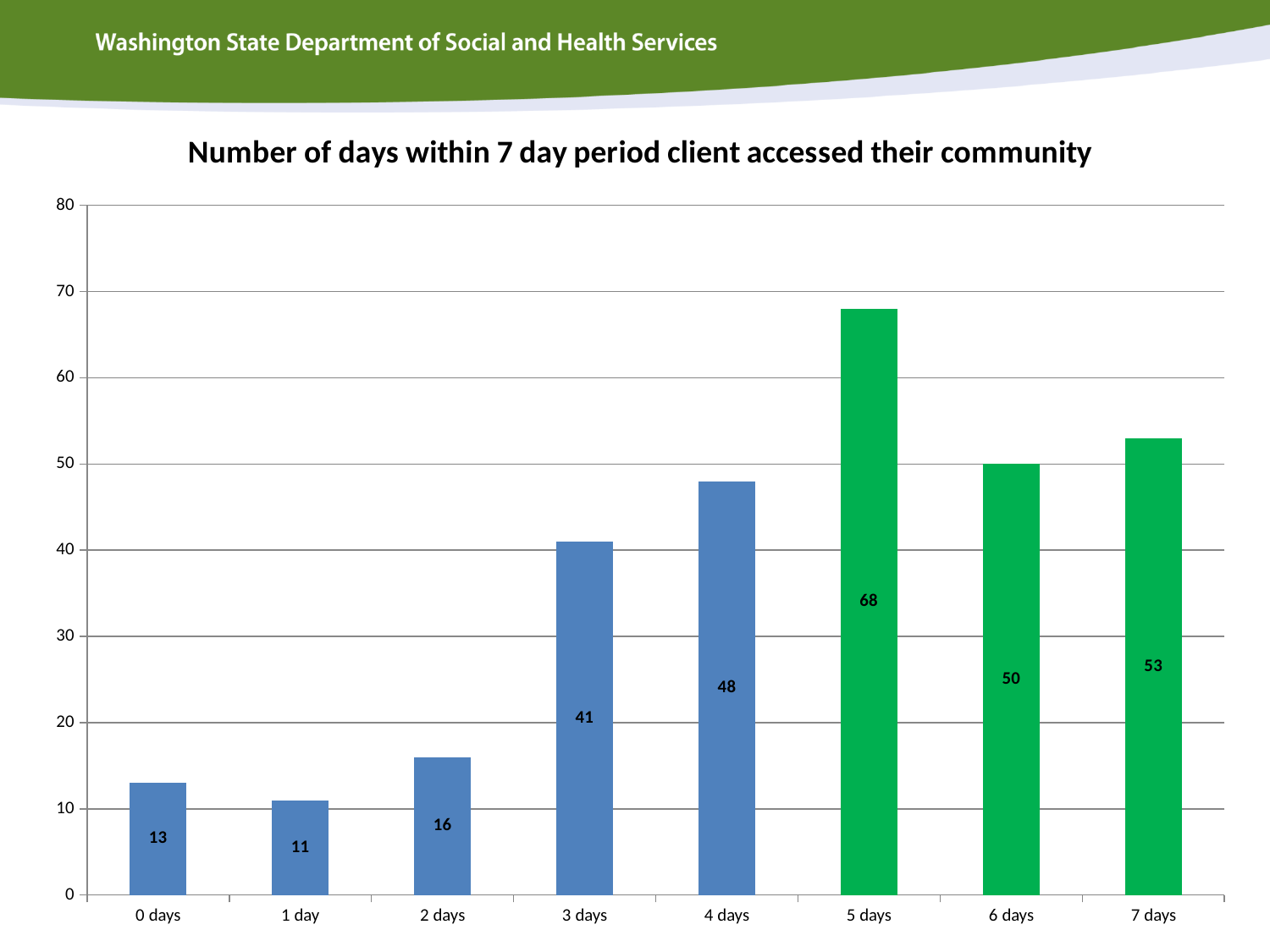
Which is larger, the value for 7 days or the value for 6 days? 7 days How many categories are shown on the x axis? 8 What is the title of the chart? Number of days within 7 day period client accessed their community What colour are the bars for 5 days, 6 days and 7 days? green What kind of chart is shown on the slide? bar chart Which category has the highest value? 5 days What is the value for 5 days? 68 What is the value for 3 days? 41 Is the value for 2 days greater or less than 20? less Which category has the lowest value? 1 day What is the value for 0 days? 13 What is the difference between the values for 5 days and 4 days? 20